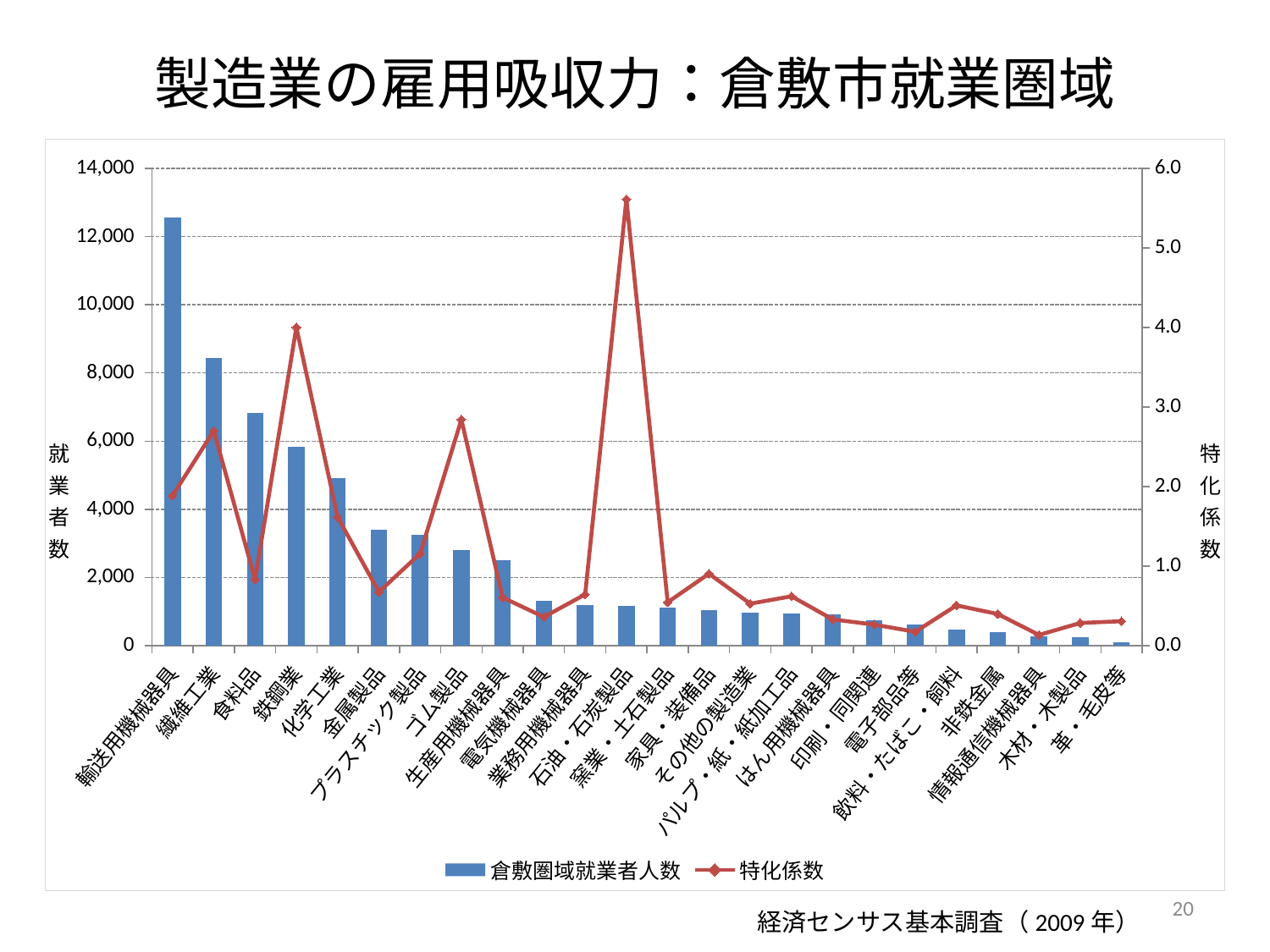
Is the 特化係数 value for 鉄鋼業 greater or less than 3.0? greater Which industry has the lowest number of employees (倉敷圏域就業者人数)? 革・毛皮等 Is the 特化係数 value for 石油・石炭製品 greater or less than 5.0? greater What kind of chart is shown on the slide? A combined bar and line chart Which has more employees, 繊維工業 or 食料品? 繊維工業 Which industry has the highest number of employees (倉敷圏域就業者人数)? 輸送用機械器具 How many industry categories are shown on the x axis? 24 Is the number of employees for 食料品 greater or less than 8,000? less How many series does the legend list? 2 Do the employee-count bars generally rise or fall from left to right along the x axis? fall Which industry has the highest 特化係数 value? 石油・石炭製品